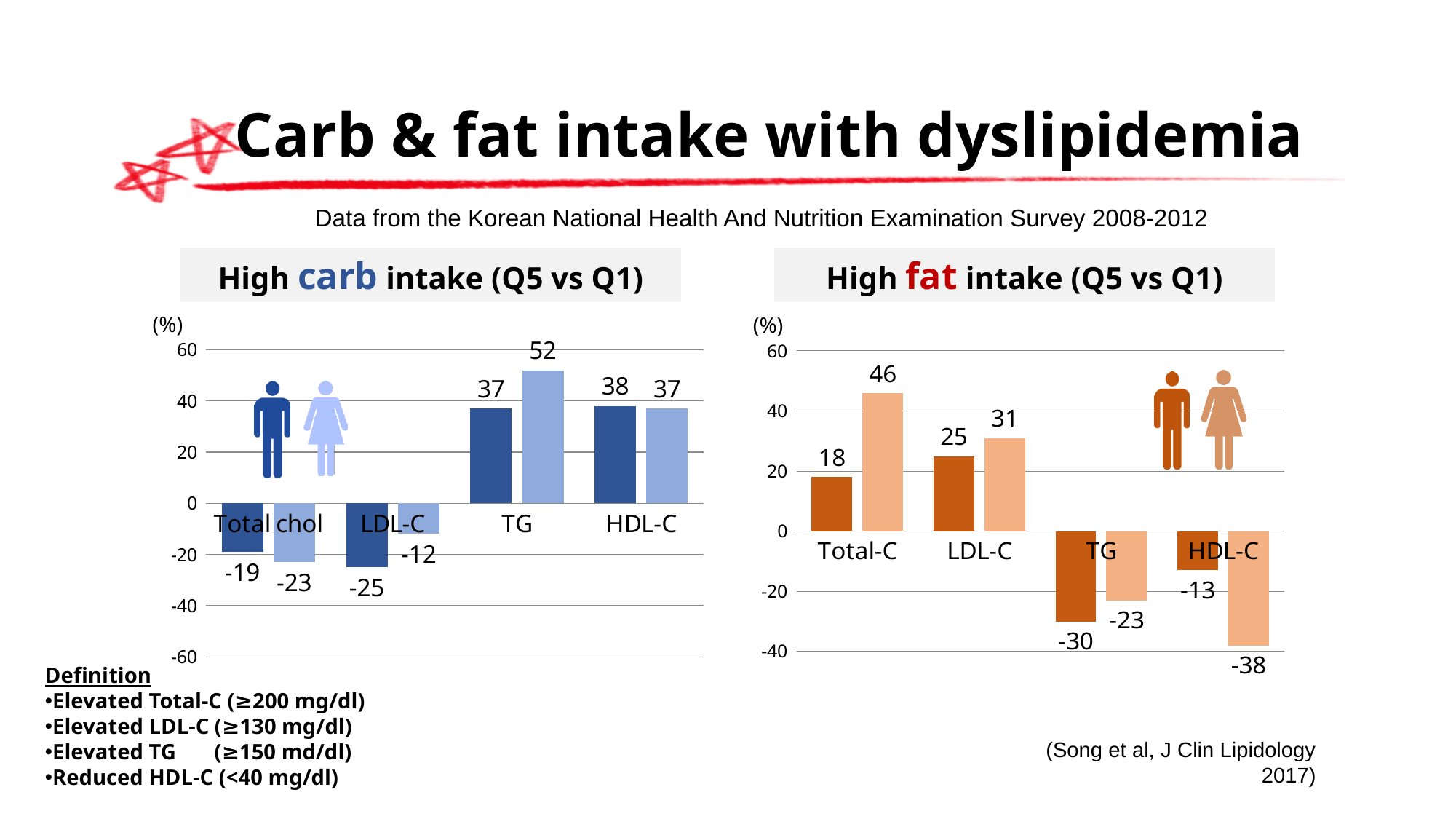
In the 'High fat intake (Q5 vs Q1)' chart, what is the value of the light orange bar for Total-C? 46 In the 'High fat intake (Q5 vs Q1)' chart, which bar has the lowest value? HDL-C (light orange bar), -38 What type of chart is used for 'High fat intake (Q5 vs Q1)'? Bar chart In the 'High carb intake (Q5 vs Q1)' chart, what is the value of the dark blue bar for LDL-C? -25 In the 'High carb intake (Q5 vs Q1)' chart, which category has the highest value? TG What unit is shown on the y axis of both charts? (%) In the 'High carb intake (Q5 vs Q1)' chart, what is the value of the light blue bar for TG? 52 In the 'High carb intake (Q5 vs Q1)' chart, which is larger for TG: the dark blue bar or the light blue bar? The light blue bar In the 'High fat intake (Q5 vs Q1)' chart, what is the difference between the light orange and dark orange bars for Total-C? 28 In the 'High fat intake (Q5 vs Q1)' chart, is the dark orange bar for TG greater or less than -20? less How many categories are shown on the x axis of the 'High carb intake (Q5 vs Q1)' chart? 4 In the 'High fat intake (Q5 vs Q1)' chart, what is the value of the dark orange bar for HDL-C? -13